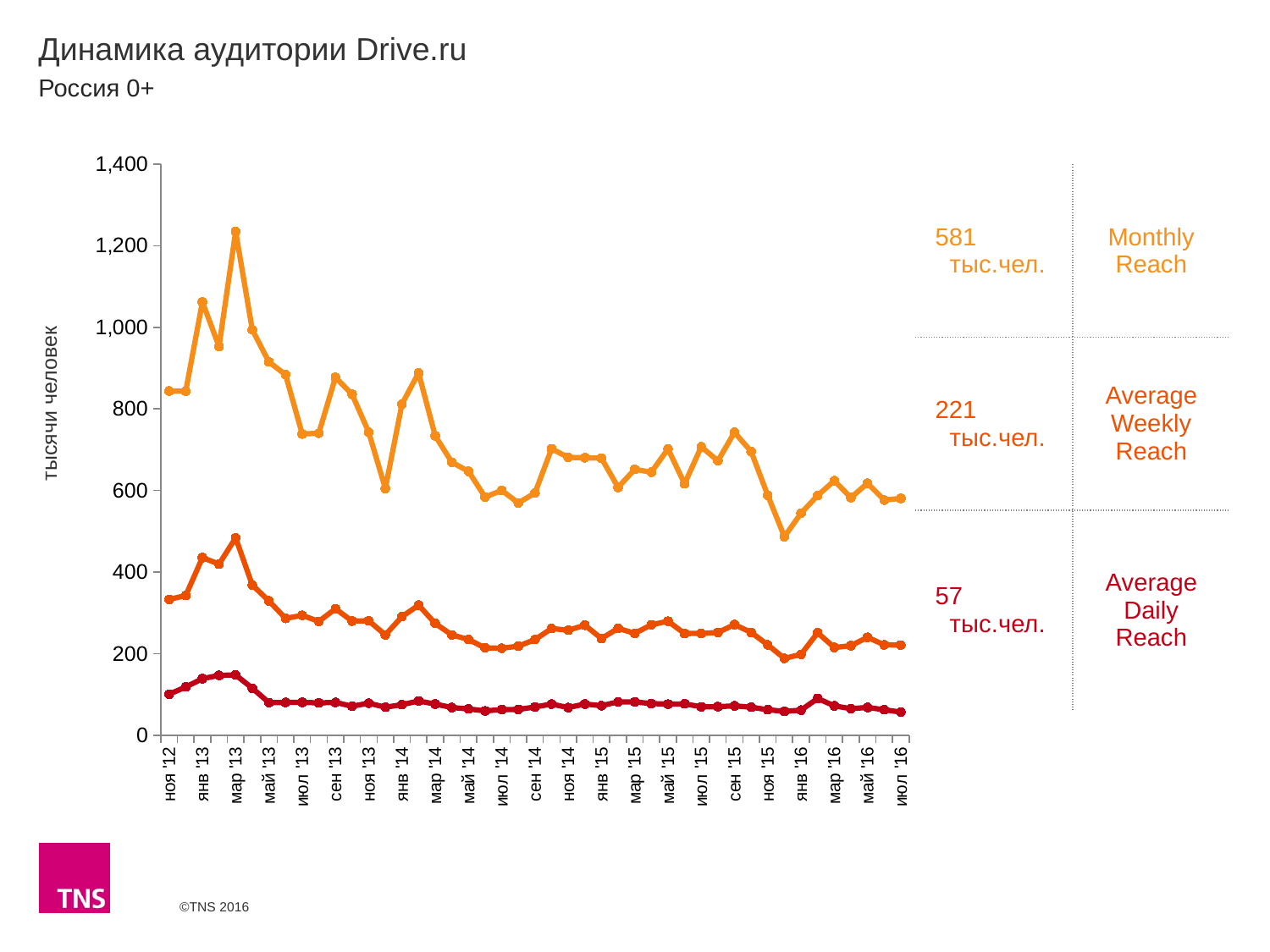
How many series are plotted on the chart? 3 What kind of chart is shown on the slide? line chart What value is shown for Average Daily Reach in the panel to the right of the chart? 57 тыс.чел. Which series has the lowest values throughout the chart? Average Daily Reach What is the difference between the Monthly Reach and Average Daily Reach values shown in the panel to the right of the chart? 524 тыс.чел. What is the label on the vertical axis of the chart? тысячи человек Is the Monthly Reach value at мар '13 greater or less than 1,000? greater What value is shown for Average Weekly Reach in the panel to the right of the chart? 221 тыс.чел. Which series has the highest values throughout the chart? Monthly Reach Is the Average Daily Reach value at мар '13 greater or less than 200? less Does the Monthly Reach line generally rise or fall from мар '13 to июл '16? fall What value is shown for Monthly Reach in the panel to the right of the chart? 581 тыс.чел.